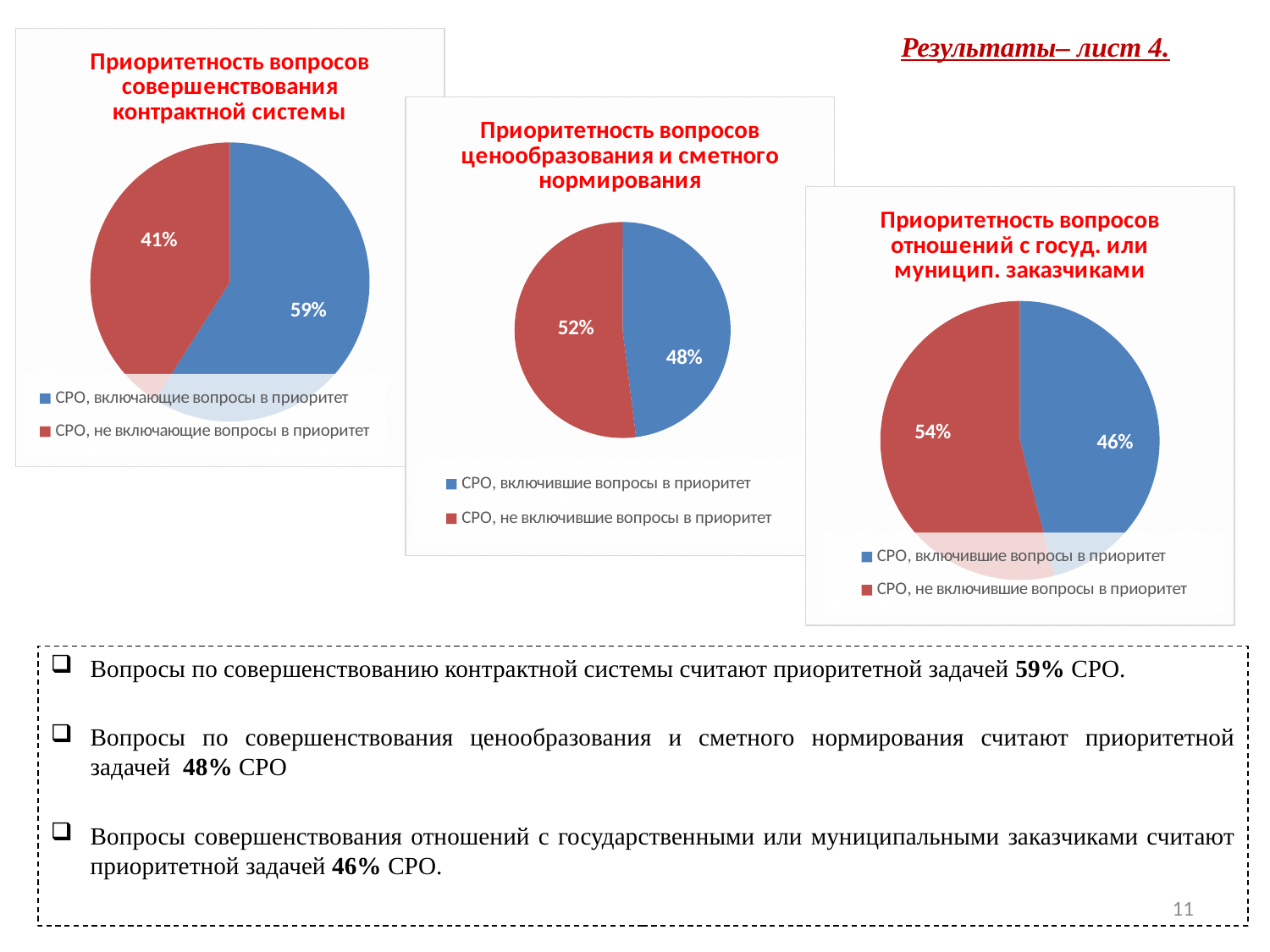
In the left chart titled "Приоритетность вопросов совершенствования контрактной системы", which slice is larger? СРО, включающие вопросы в приоритет In the left chart titled "Приоритетность вопросов совершенствования контрактной системы", what is the difference between the two slices? 18% In the middle chart titled "Приоритетность вопросов ценообразования и сметного нормирования", what share is shown for "СРО, включившие вопросы в приоритет"? 48% In the right chart titled "Приоритетность вопросов отношений с госуд. или муницип. заказчиками", what share is shown for "СРО, включившие вопросы в приоритет"? 46% How many slices does the middle chart titled "Приоритетность вопросов ценообразования и сметного нормирования" have? 2 In the right chart titled "Приоритетность вопросов отношений с госуд. или муницип. заказчиками", which slice is the smallest? СРО, включившие вопросы в приоритет In the left chart titled "Приоритетность вопросов совершенствования контрактной системы", what share is shown for "СРО, не включающие вопросы в приоритет"? 41% In the right chart titled "Приоритетность вопросов отношений с госуд. или муницип. заказчиками", what share is shown for "СРО, не включившие вопросы в приоритет"? 54% In the left chart titled "Приоритетность вопросов совершенствования контрактной системы", what share is shown for "СРО, включающие вопросы в приоритет"? 59% How many entries does the legend of the right chart titled "Приоритетность вопросов отношений с госуд. или муницип. заказчиками" list? 2 What kind of chart is the left chart titled "Приоритетность вопросов совершенствования контрактной системы"? Pie chart In the middle chart titled "Приоритетность вопросов ценообразования и сметного нормирования", what share is shown for "СРО, не включившие вопросы в приоритет"? 52%